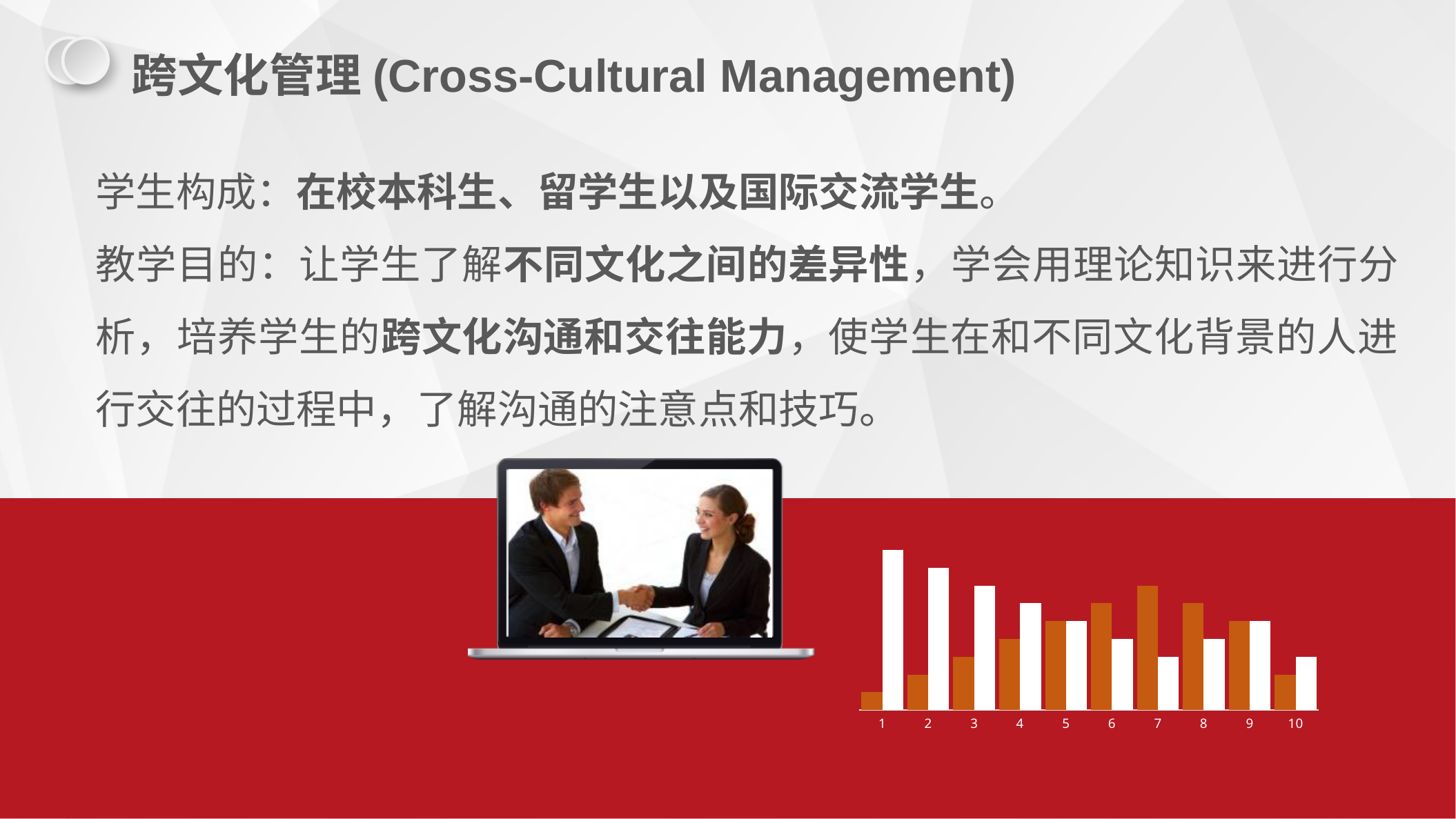
In category 1 of the bar chart, which bar is taller, the orange one or the white one? white In category 7 of the bar chart, which bar is taller, the orange one or the white one? orange What kind of chart is shown at the bottom right of the slide? bar chart Which category has the tallest orange bar in the bar chart? 7 What two colours are used for the bars in the bar chart? orange and white How many categories are shown on the x axis of the bar chart? 10 Is the white bar for category 2 taller or shorter than the white bar for category 6? taller Do the white bars in the bar chart generally rise or fall from category 1 to category 10? fall How many series of bars are plotted for each category in the bar chart? 2 Which category has the shortest orange bar in the bar chart? 1 Which category has the tallest white bar in the bar chart? 1